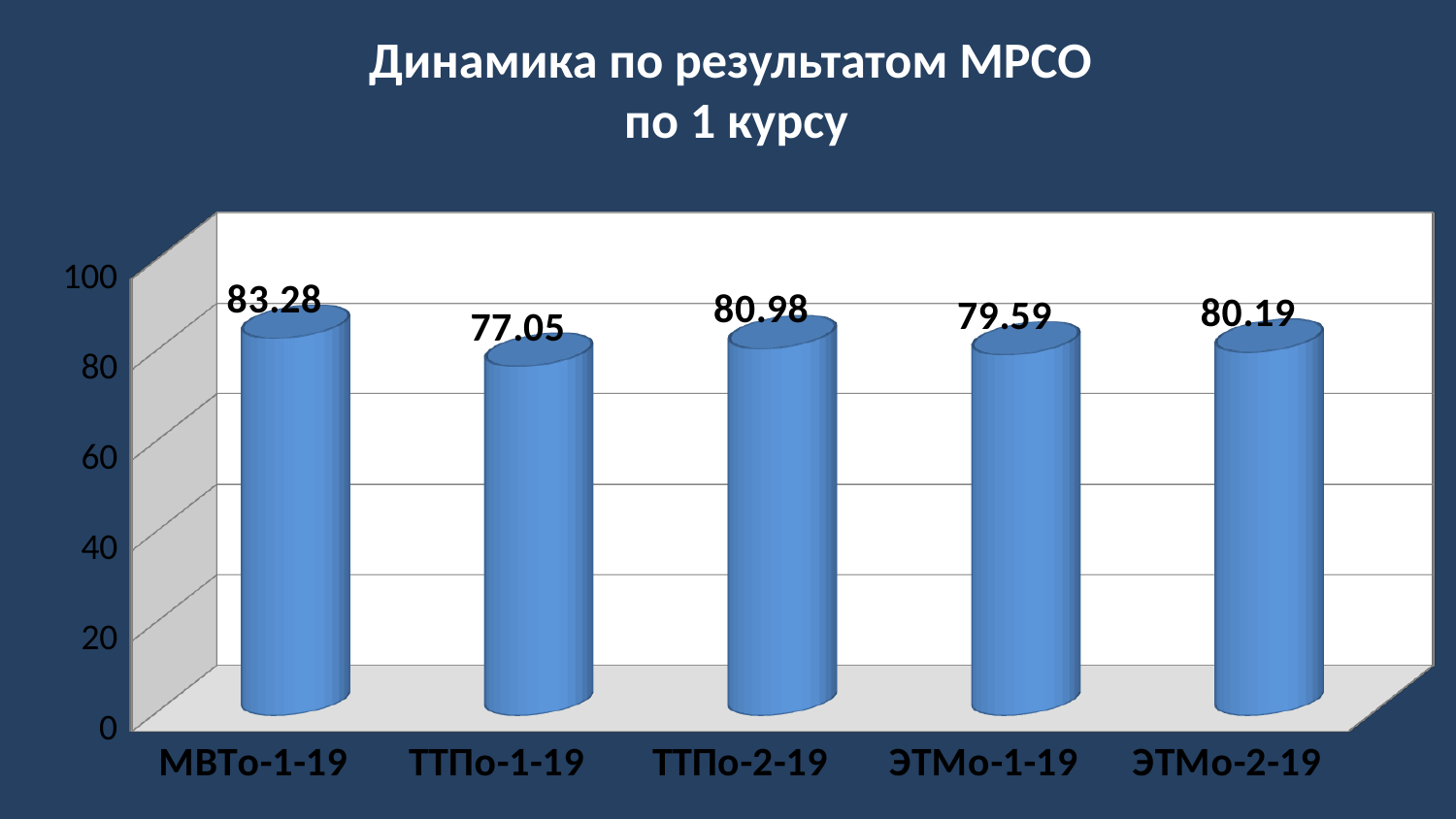
What is the value for ЭТМо-1-19? 79.59 How many groups are shown on the chart? 5 What is the value for МВТо-1-19? 83.28 Is the value for ТТПо-1-19 greater or less than 80? less What is the difference between the values for ТТПо-2-19 and ЭТМо-2-19? 0.79 Which is larger, the value for ТТПо-2-19 or the value for ЭТМо-1-19? ТТПо-2-19 What kind of chart is shown on the slide? bar chart What is the difference between the values for МВТо-1-19 and ТТПо-1-19? 6.23 Which group has the lowest value? ТТПо-1-19 What is the title of the chart? Динамика по результатом МРСО по 1 курсу Which group has the highest value? МВТо-1-19 What is the value for ТТПо-1-19? 77.05